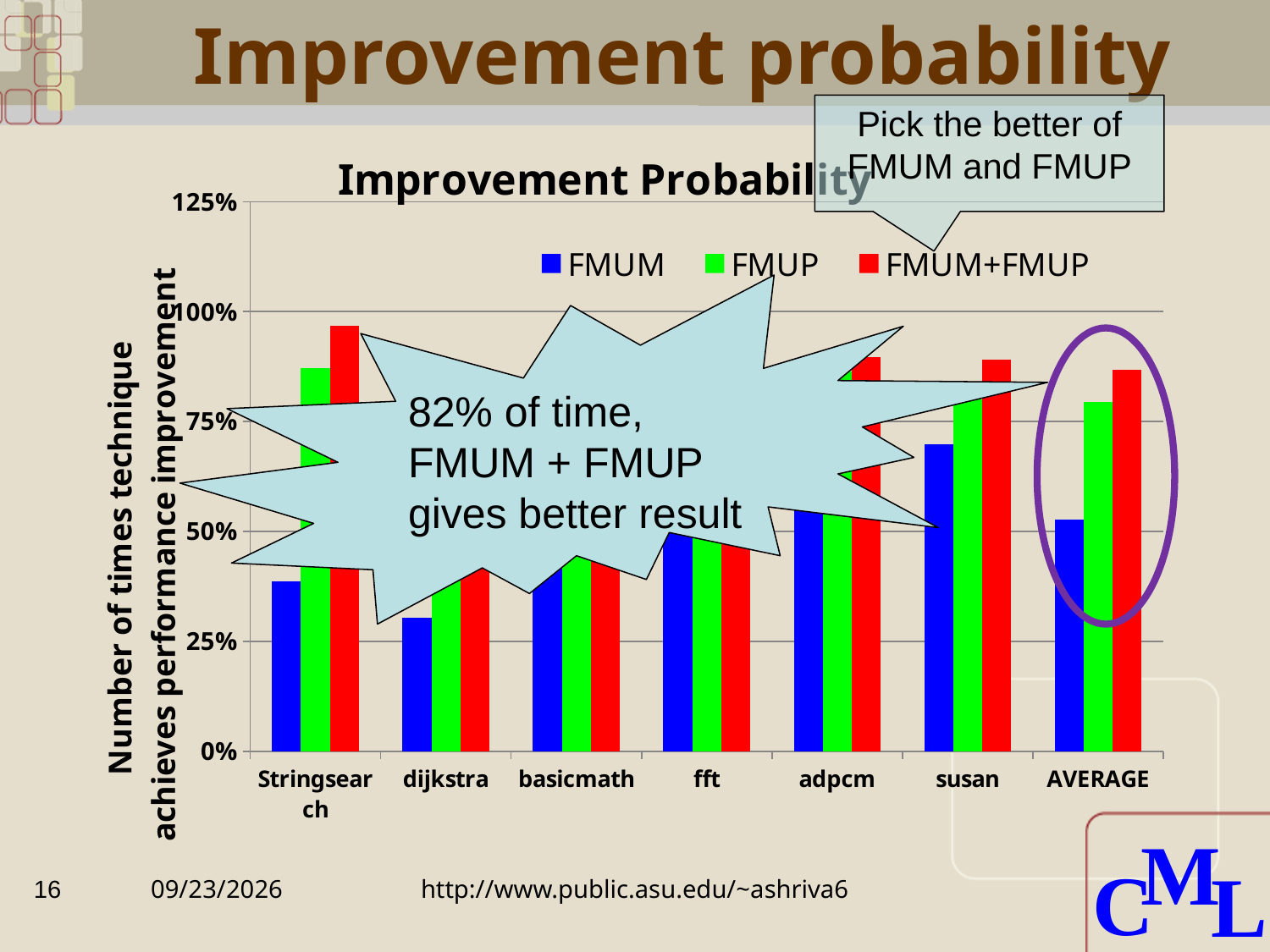
Is the FMUM+FMUP value for AVERAGE greater or less than 75%? greater Is the FMUM value for dijkstra greater or less than 25%? greater Is the FMUM value for susan greater or less than 75%? less What kind of chart is shown on the slide? bar chart How many categories are shown on the x axis of the Improvement Probability chart? 7 Which category has the lowest FMUM value? dijkstra What is the title of the chart on the slide? Improvement Probability How many series does the legend of the Improvement Probability chart list? 3 For Stringsearch, which is larger, the FMUM value or the FMUP value? FMUP Which series is shown in red in the Improvement Probability chart? FMUM+FMUP For AVERAGE, which series has the highest bar? FMUM+FMUP